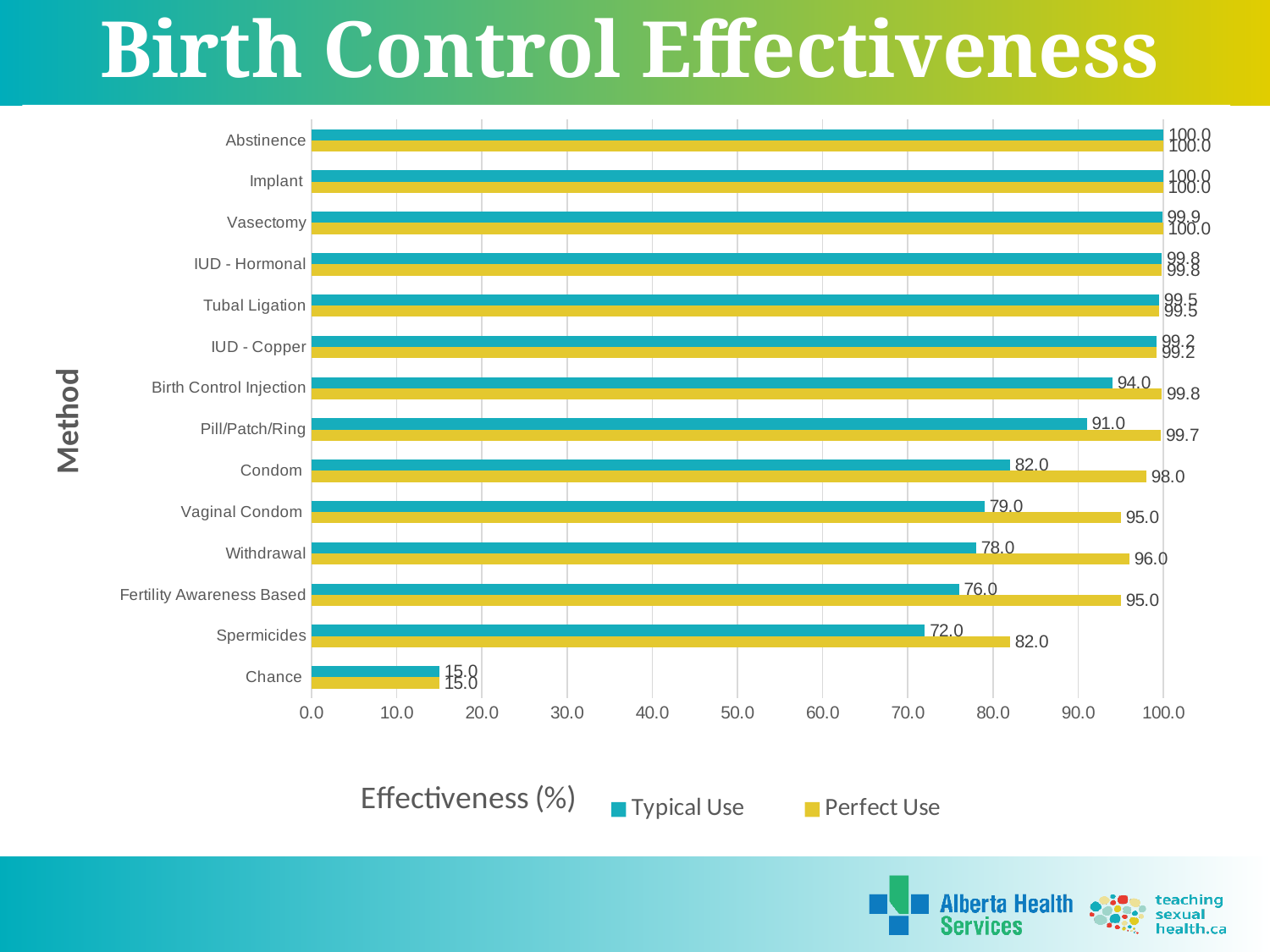
What is the Typical Use value for Condom? 82.0 Is the Typical Use value for Pill/Patch/Ring greater or less than 90.0? greater How many methods are listed on the chart? 14 How many series does the legend list? 2 What is the difference between the Perfect Use and Typical Use values for Condom? 16.0 What is the Typical Use value for Spermicides? 72.0 What kind of chart is shown on the slide? bar chart Which has the larger Typical Use value, Withdrawal or Vaginal Condom? Vaginal Condom What is the difference between the Perfect Use and Typical Use values for Spermicides? 10.0 Which method has the lowest Typical Use value? Chance What is the Perfect Use value for Birth Control Injection? 99.8 What is the Perfect Use value for Withdrawal? 96.0